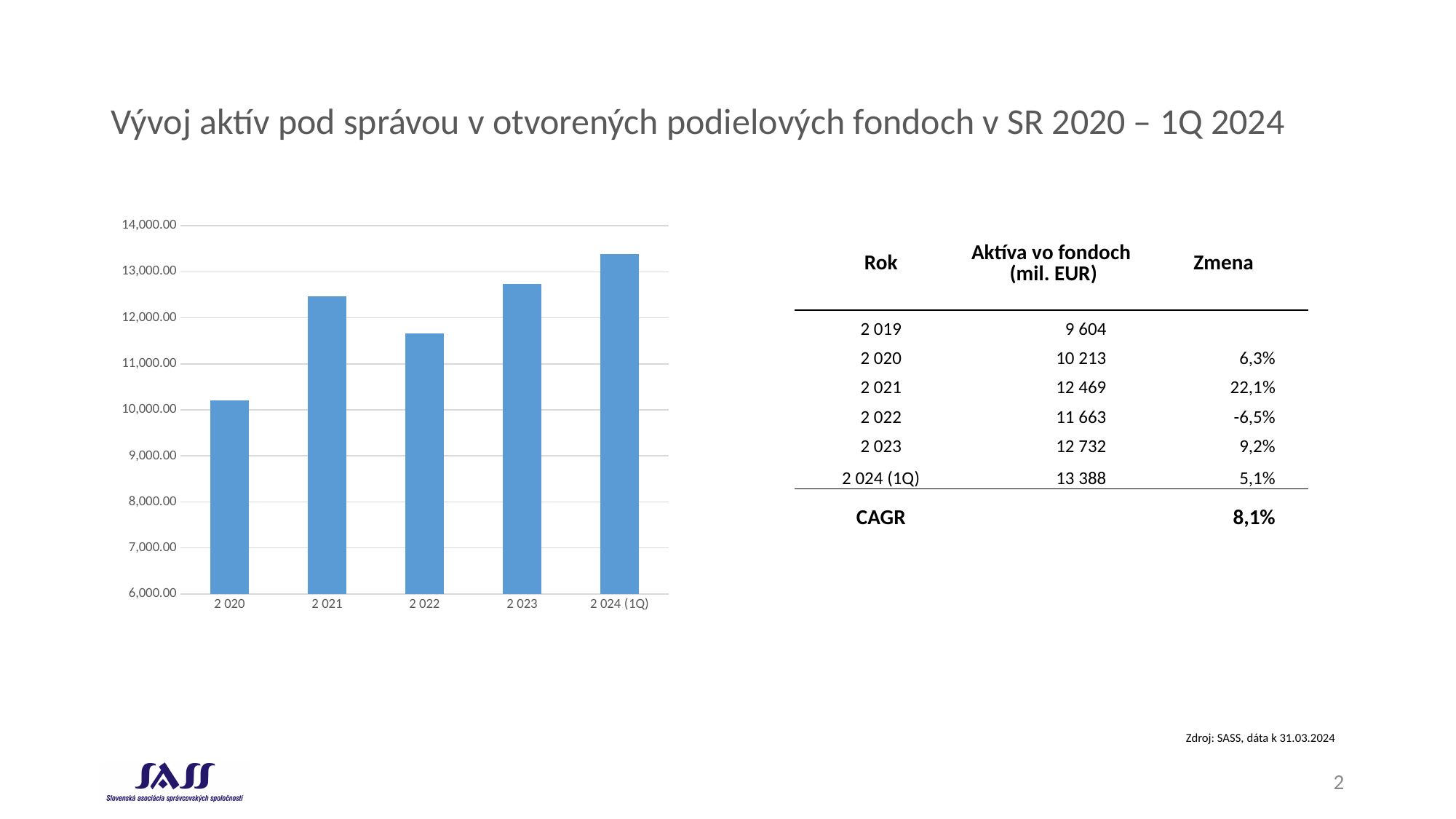
Is the value for 2 024 (1Q) greater or less than 13,000? greater How many bars (years) does the chart show? 5 According to the table on the slide, what are the assets in funds (mil. EUR) for 2 024 (1Q)? 13 388 Using the values in the table, what is the difference in assets between 2 024 (1Q) and 2 020 (mil. EUR)? 3 175 Do the bar values rise steadily from 2 020 to 2 024 (1Q), or is there a dip? There is a dip in 2 022 Which bar is taller, 2 021 or 2 023? 2 023 Is the value for 2 022 greater or less than 12,000? less According to the table on the slide, what are the assets in funds (mil. EUR) for 2 021? 12 469 Which year has the highest bar in the chart? 2 024 (1Q) Which year has the lowest bar in the chart? 2 020 Is the value for 2 020 greater or less than 10,000? greater What kind of chart is shown on the slide? bar chart